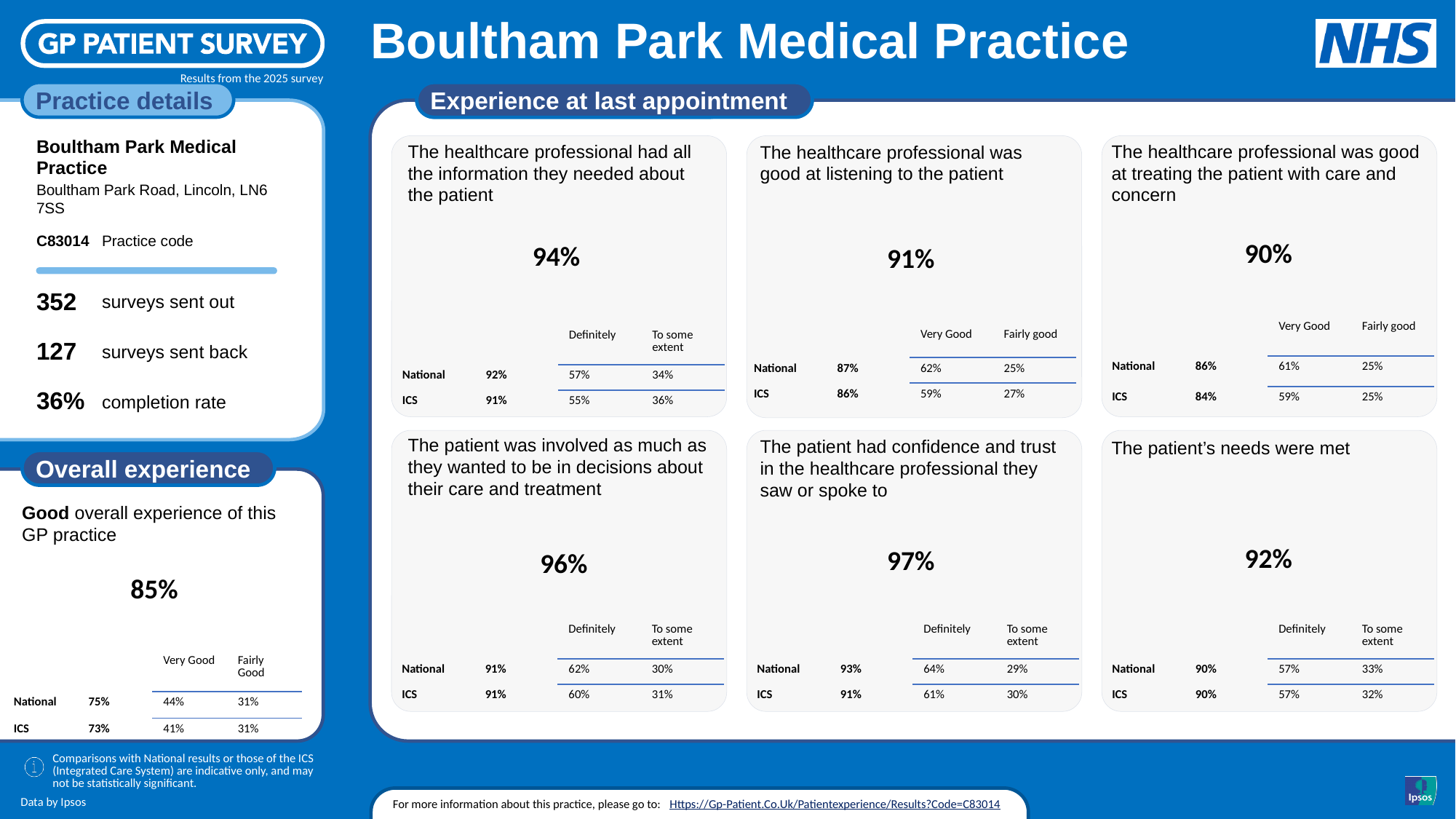
For 'The healthcare professional was good at treating the patient with care and concern', what is the ICS value shown? 84% How many statements are shown in the 'Experience at last appointment' section? 6 In the 'Overall experience' panel, what are the two response categories listed in the comparison table? Very Good and Fairly Good For 'The patient's needs were met', is the practice value higher or lower than the National value? higher For 'The healthcare professional was good at listening to the patient', what is the difference between the practice value and the ICS value? 5 percentage points In the 'Overall experience' panel, what is the difference between the practice's 85% and the National value of 75%? 10 percentage points In the 'Overall experience' panel, what percentage of patients reported a good overall experience of this GP practice? 85% In the 'Experience at last appointment' section, which of the six statements has the highest practice percentage? The patient had confidence and trust in the healthcare professional they saw or spoke to In the 'Overall experience' panel, what is the National value shown? 75% In the 'Experience at last appointment' section, which of the six statements has the lowest practice percentage? The healthcare professional was good at treating the patient with care and concern In the 'Experience at last appointment' section, what percentage is shown for 'The patient had confidence and trust in the healthcare professional they saw or spoke to'? 97% In the 'Experience at last appointment' section, what percentage is shown for 'The healthcare professional had all the information they needed about the patient'? 94%